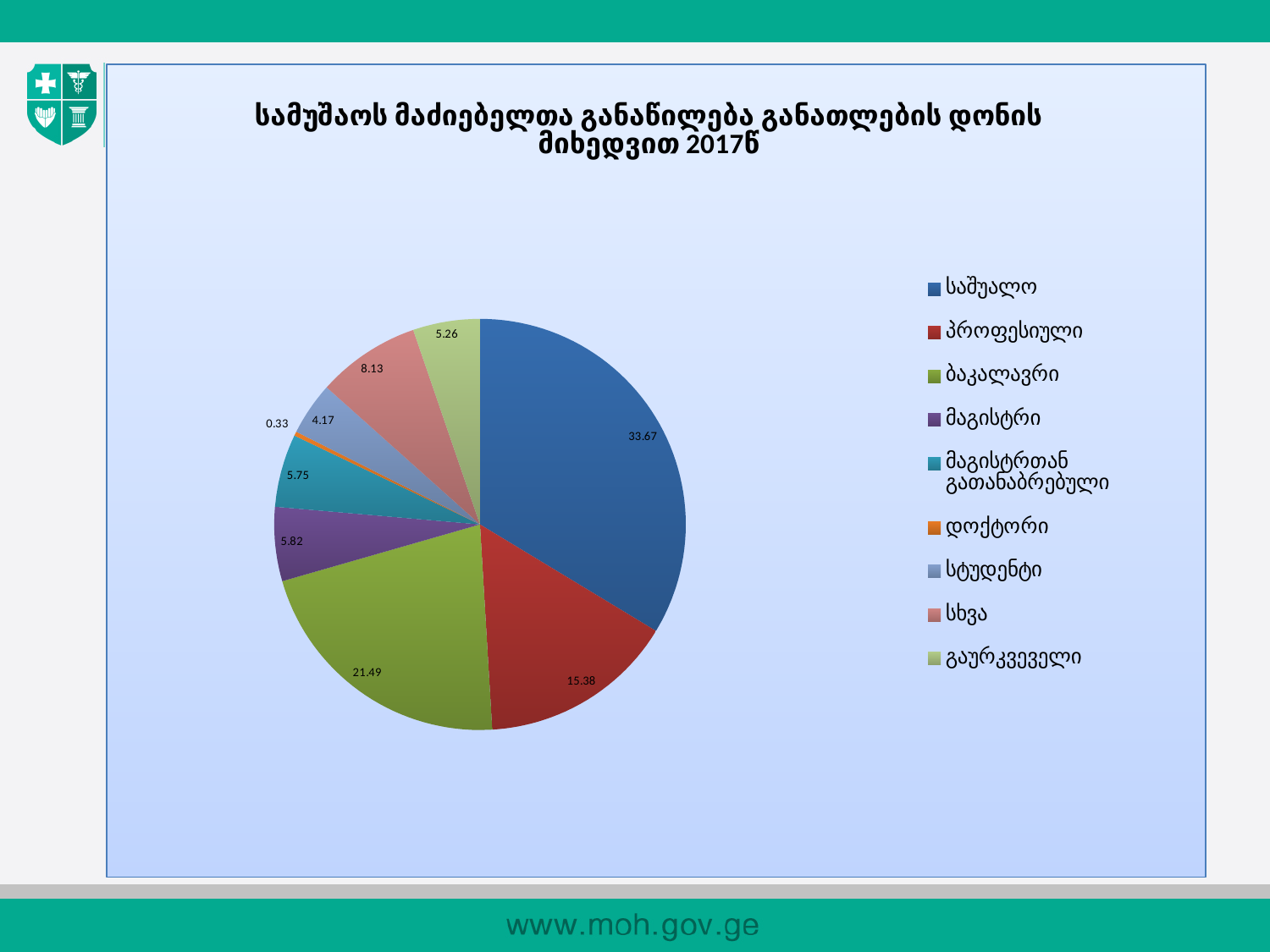
What is the value shown for the დოქტორი slice? 0.33 Which is larger, the value for სტუდენტი or the value for გაურკვეველი? გაურკვეველი Which category has the smallest slice of the pie? დოქტორი What type of chart is shown on the slide? pie chart What is the value shown for the მაგისტრი slice? 5.82 Which category has the largest slice of the pie? საშუალო How many categories does the legend list? 9 What is the value shown for the ბაკალავრი slice? 21.49 What is the value shown for the სხვა slice? 8.13 What is the value shown for the საშუალო slice? 33.67 What is the difference between the values for საშუალო and პროფესიული? 18.29 What colour is the საშუალო slice? blue